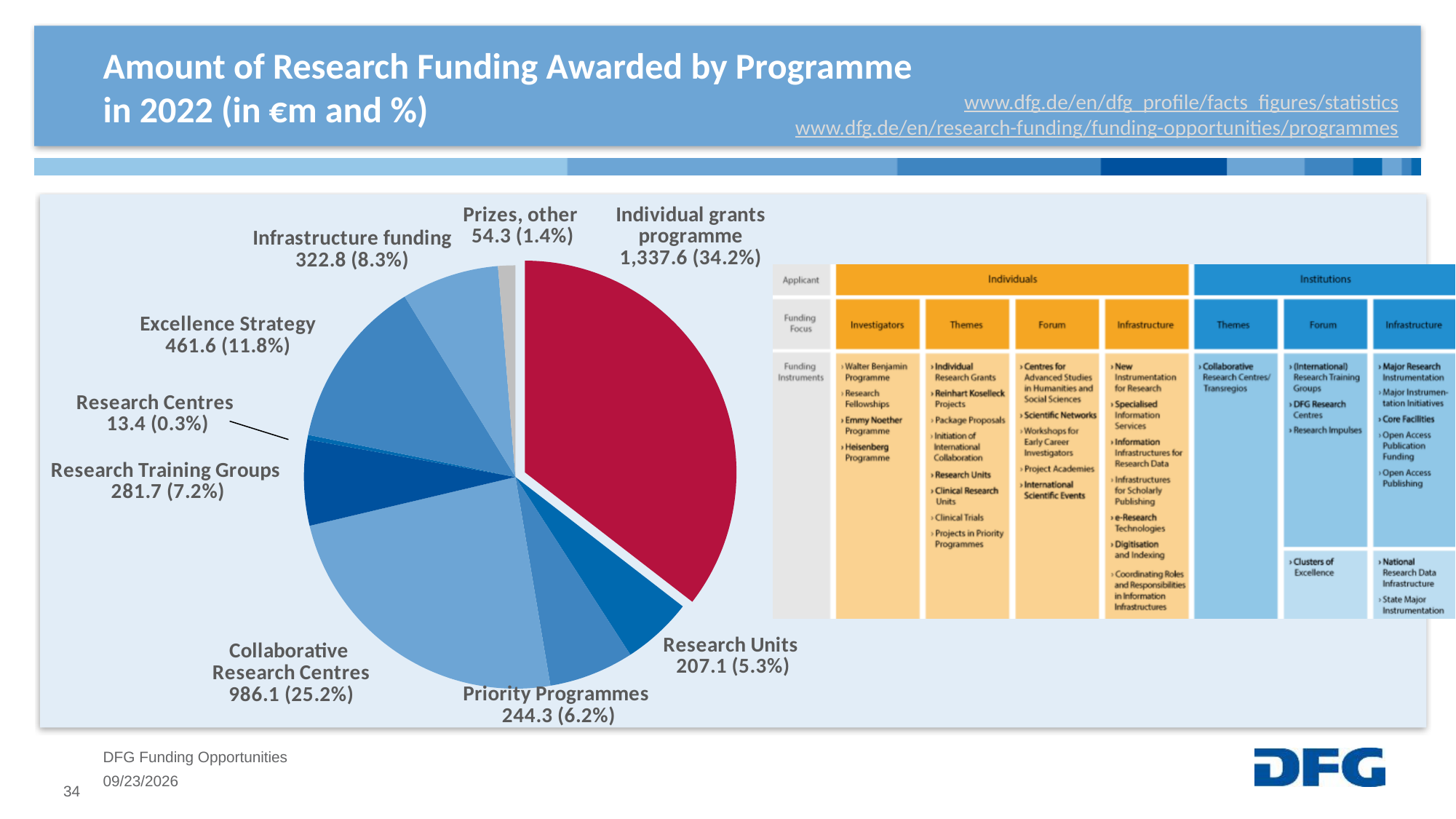
Which received more funding, Excellence Strategy or Infrastructure funding? Excellence Strategy What share of the total funding went to Collaborative Research Centres? 25.2% What is the title of the chart on the slide? Amount of Research Funding Awarded by Programme in 2022 (in €m and %) What amount of funding (in €m) was awarded to the Individual grants programme? 1,337.6 What kind of chart is shown on the slide? pie chart What amount of funding (in €m) was awarded to Research Units? 207.1 Which programme received the smallest amount of funding? Research Centres Which programme received the largest amount of funding? Individual grants programme What share of the total funding went to Excellence Strategy? 11.8% What amount of funding (in €m) was awarded to Collaborative Research Centres? 986.1 How many categories does the pie chart show? 9 What is the difference in funding (in €m) between the Individual grants programme and Collaborative Research Centres? 351.5